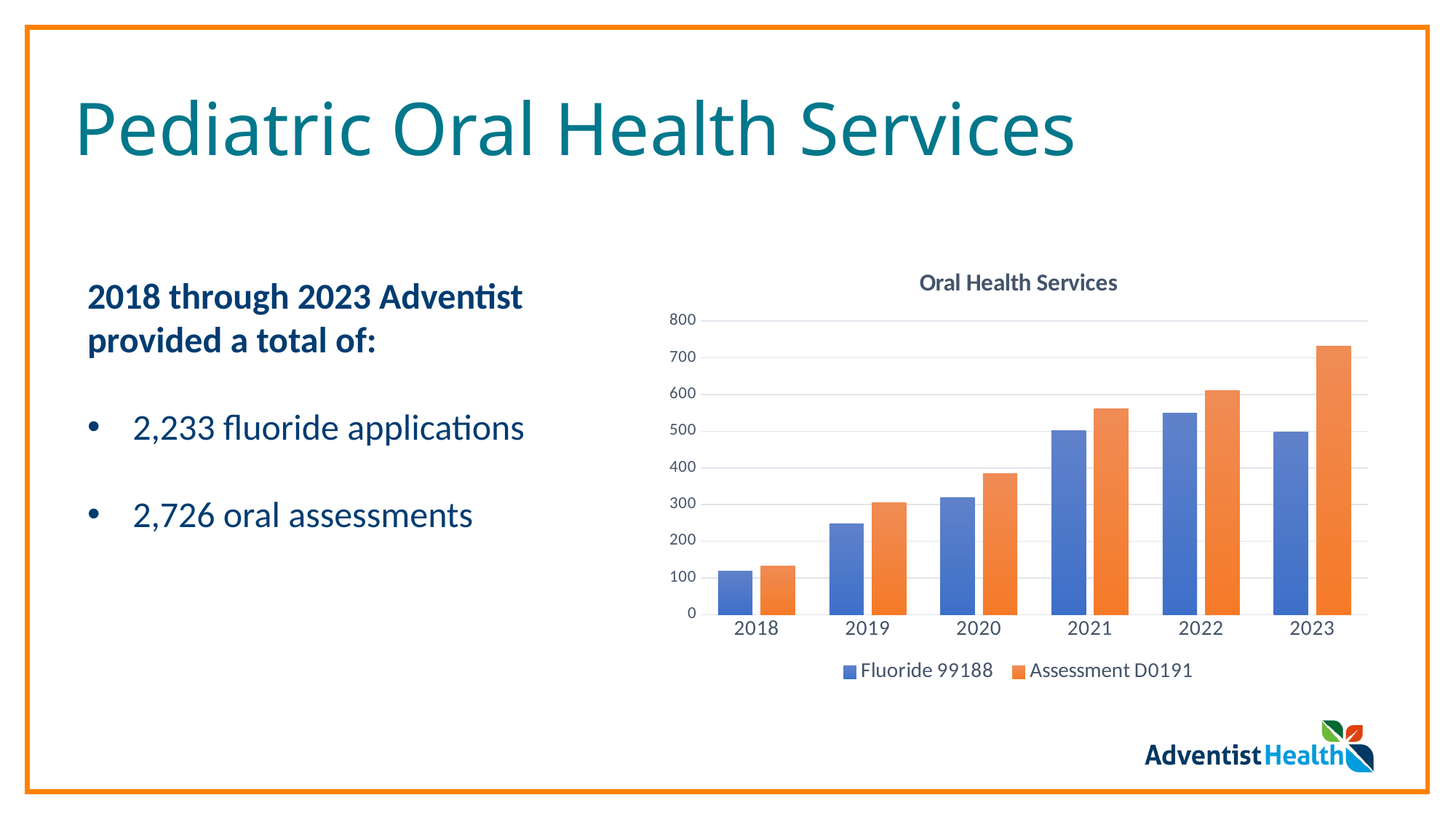
Is the Fluoride 99188 value for 2019 greater or less than 200? greater In 2023, which series has the larger value, Fluoride 99188 or Assessment D0191? Assessment D0191 In which year is the Fluoride 99188 value highest? 2022 Which series is shown in orange in the Oral Health Services chart? Assessment D0191 How many years are shown on the x axis of the Oral Health Services chart? 6 How many series does the legend of the Oral Health Services chart list? 2 In which year is the Assessment D0191 value highest? 2023 Is the Assessment D0191 value for 2023 greater or less than 700? greater Does the Assessment D0191 series rise or fall from 2018 to 2023? rise What type of chart is shown under the title "Oral Health Services"? bar chart Is the Fluoride 99188 value for 2023 greater or less than 600? less In which year is the Fluoride 99188 value lowest? 2018